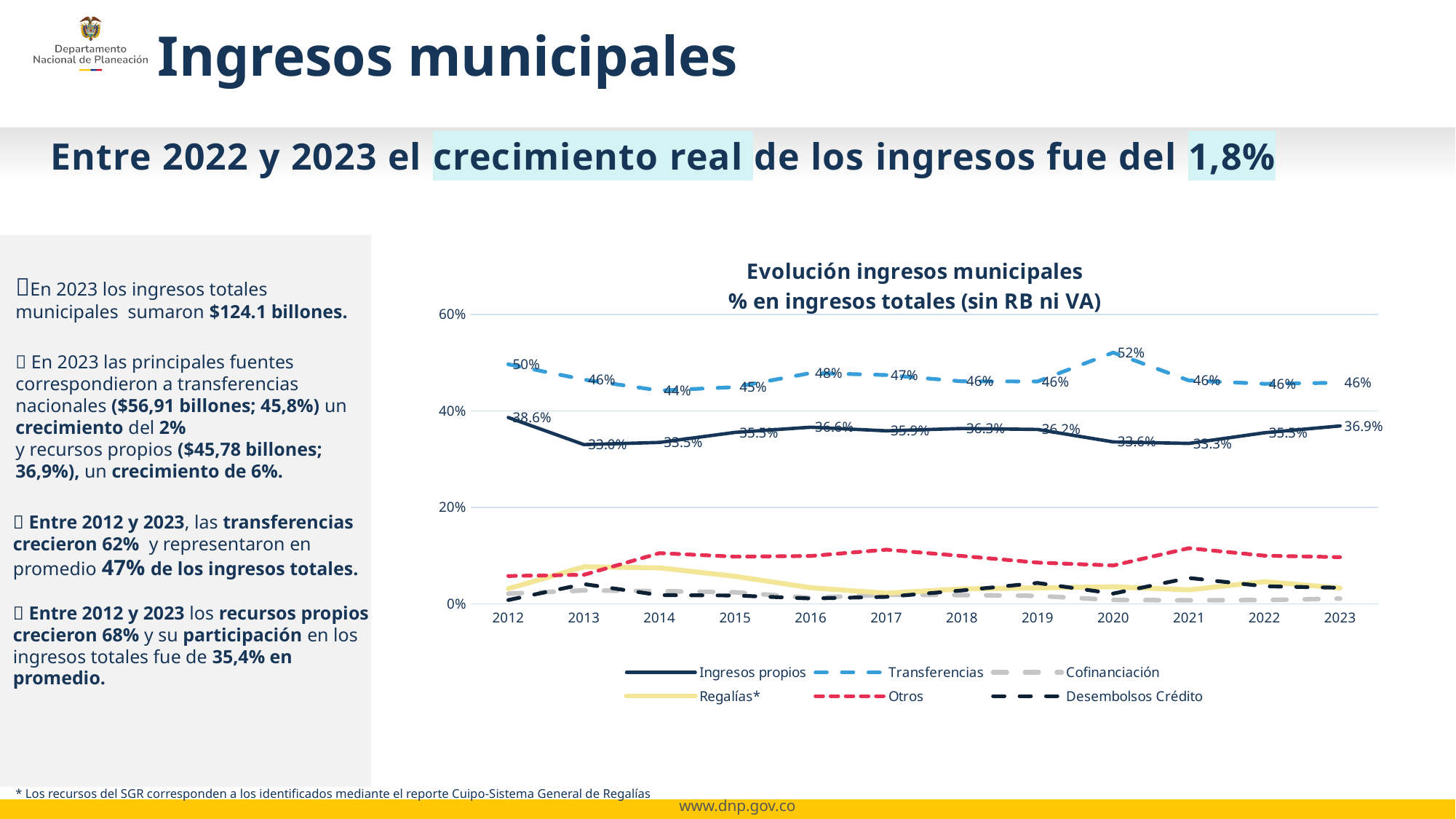
In which year does Transferencias reach its lowest value? 2014 Is the value for Otros in 2021 greater or less than 20%? less In which year does Transferencias reach its highest value? 2020 What is the value of Transferencias in 2012? 50% In which year does Ingresos propios reach its highest value? 2012 By how many percentage points did Transferencias fall between 2012 and 2023? 4 percentage points In 2023, which is larger: Transferencias or Ingresos propios? Transferencias How many years are plotted along the x axis of the chart? 12 How many series does the legend of the chart list? 6 What kind of chart is shown on the slide? line chart What is the value of Ingresos propios in 2023? 36.9% What is the value of Transferencias in 2020? 52%